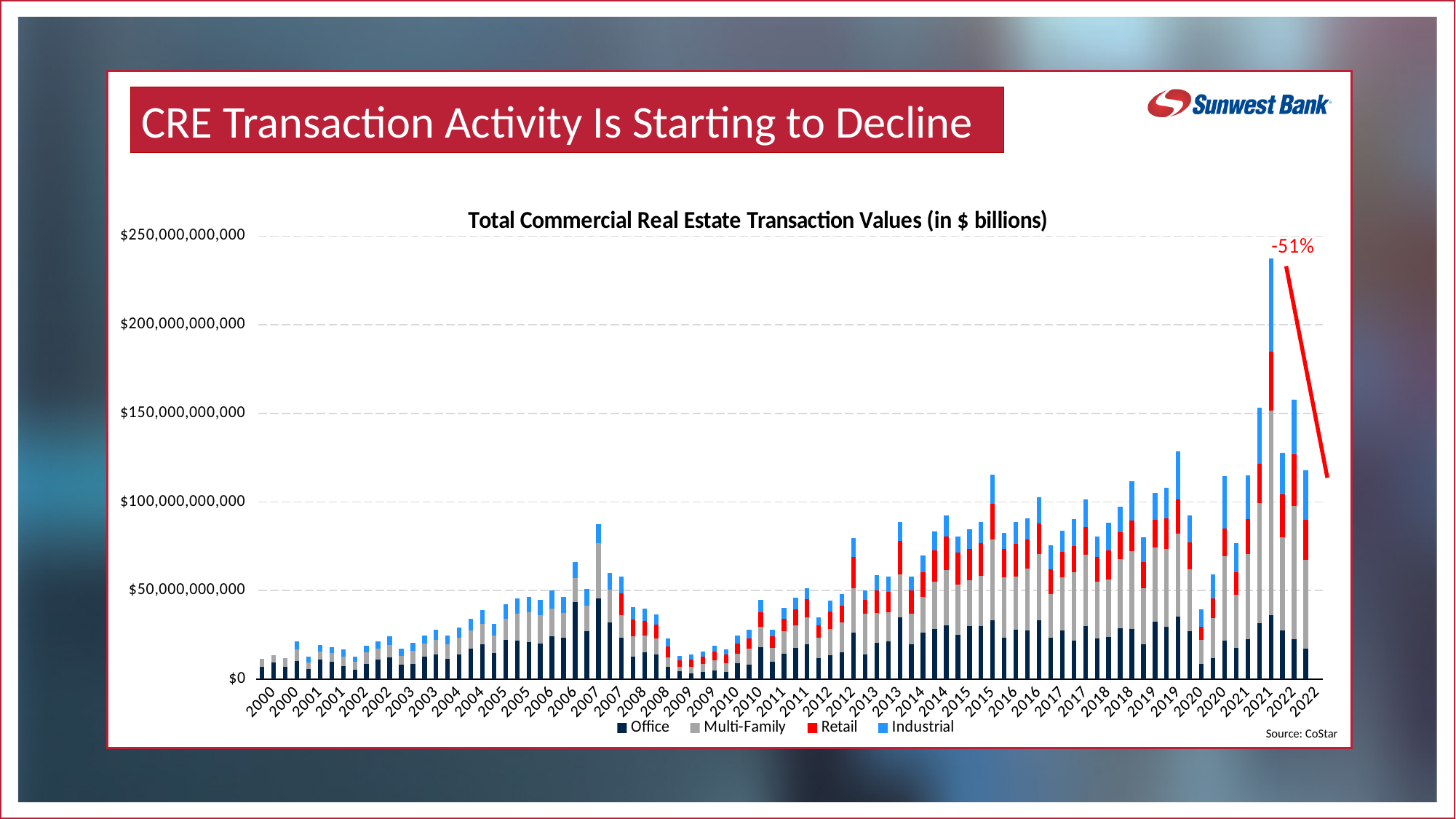
What are the four series listed in the legend? Office, Multi-Family, Retail, Industrial Is the tallest bar in 2007 greater or less than $100,000,000,000? less Which year has taller bars overall, 2021 or 2009? 2021 Do the total transaction values rise or fall from 2007 to 2009? fall In which year does the tallest stacked bar appear? 2021 What kind of chart is shown on the slide? Stacked bar chart How many series does the legend list? 4 Are the bars for 2009 greater or less than $50,000,000,000? less What percentage change is annotated in red at the top right of the chart? -51% What is the source cited for the chart data? CoStar What is the title of the chart? Total Commercial Real Estate Transaction Values (in $ billions) Is the tallest bar in 2021 greater or less than $200,000,000,000? greater